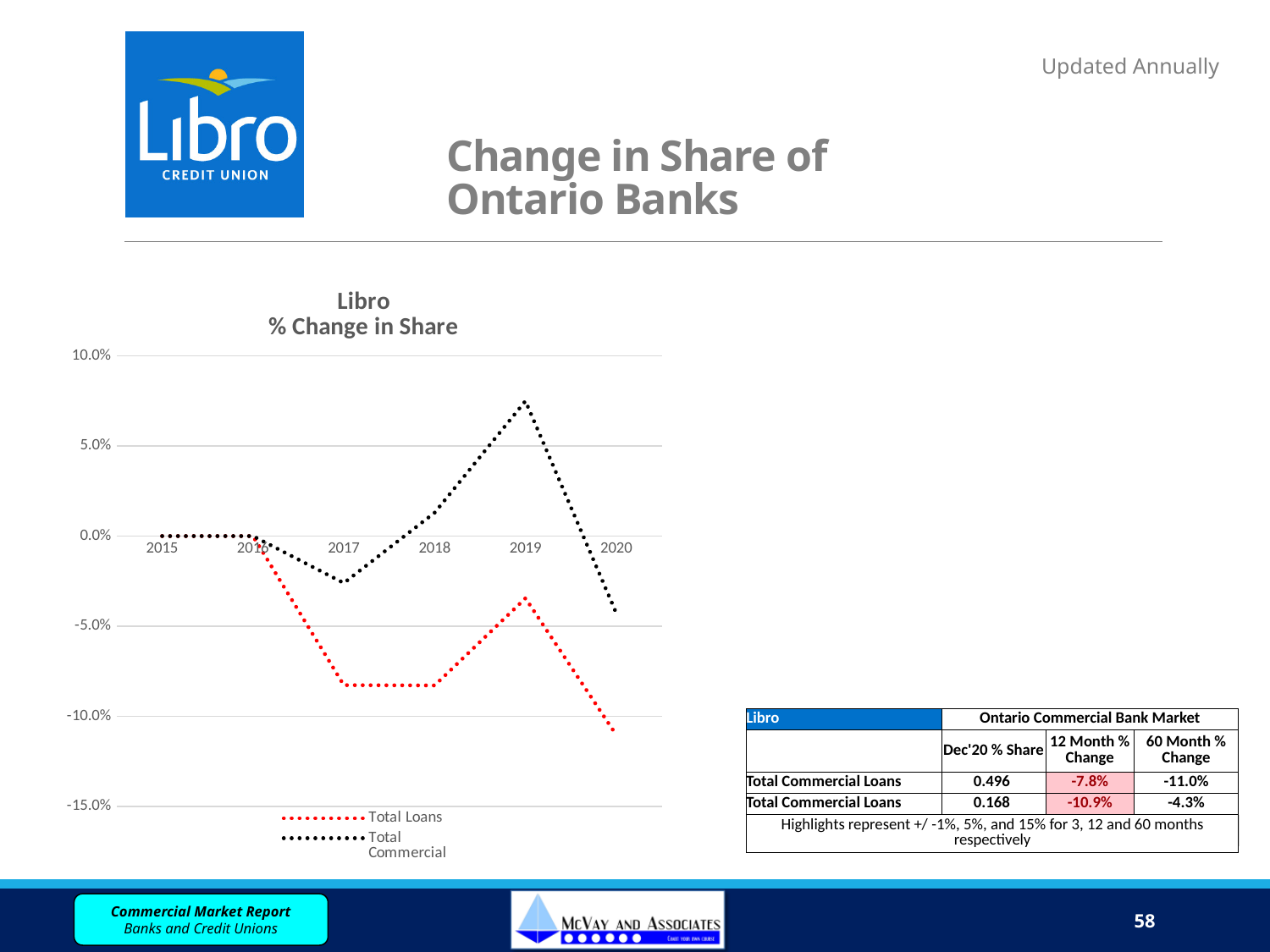
Is the value for Total Commercial in 2019 greater or less than 5.0%? greater How many years are shown on the x axis of the chart? 6 Does the Total Loans series rise or fall between 2019 and 2020? fall How many series does the legend of the chart list? 2 Is the value for Total Loans in 2017 greater or less than -5.0%? less Is the value for Total Commercial in 2020 greater or less than 0.0%? less What type of chart is shown on the slide? line chart In 2019, which series has the higher value, Total Loans or Total Commercial? Total Commercial In which year does the Total Commercial series reach its highest value? 2019 Does the Total Commercial series rise or fall between 2017 and 2019? rise In which year does the Total Loans series reach its lowest value? 2020 What is the title of the chart? Libro % Change in Share